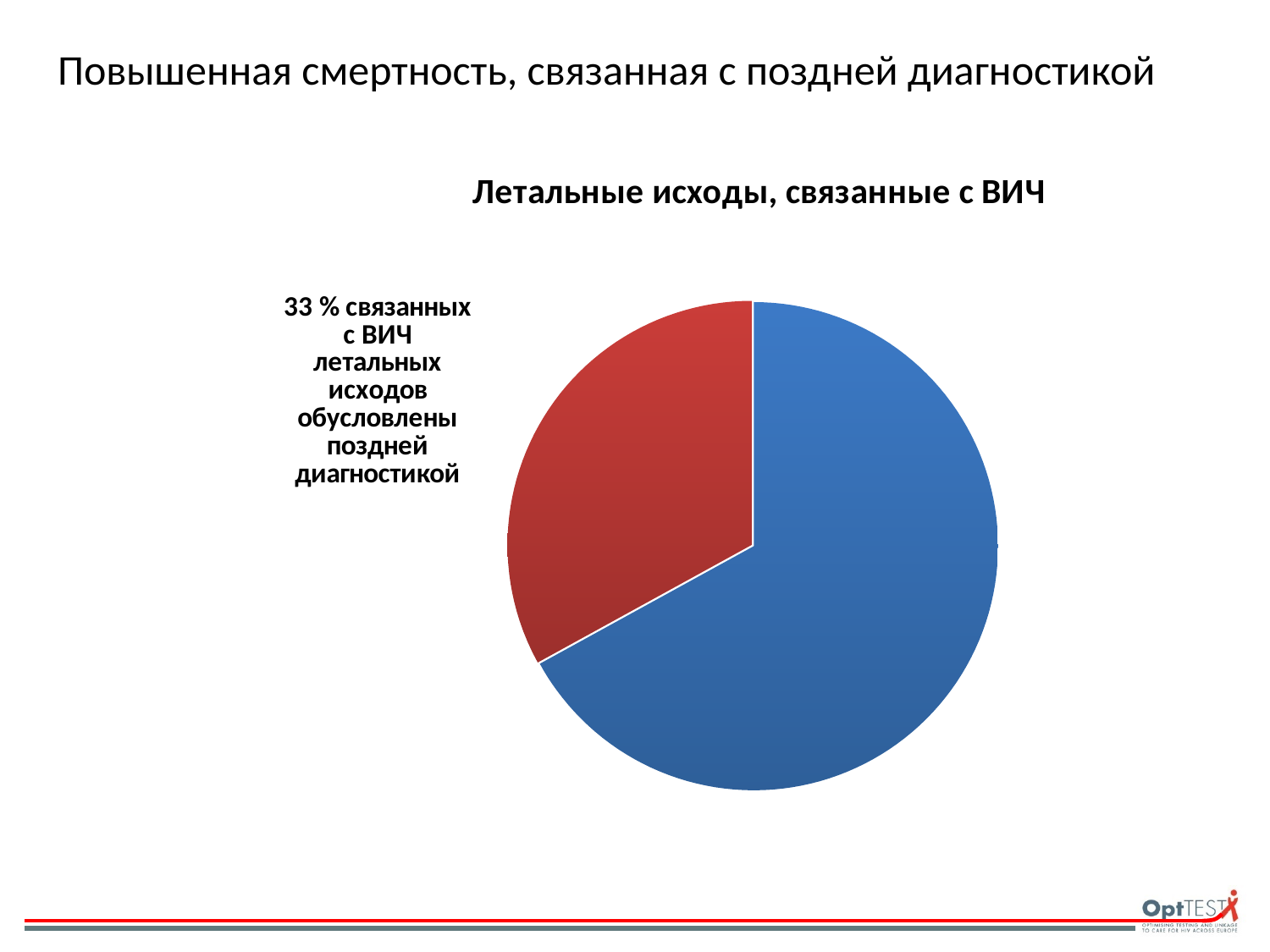
What is the title of the chart? Летальные исходы, связанные с ВИЧ Which slice is larger, the red slice or the blue slice? the blue slice What share of HIV-related deaths is attributed to late diagnosis (поздней диагностикой) according to the chart? 33 % Is the share of deaths due to late diagnosis greater or less than 50%? less How many slices does the pie chart have? 2 What kind of chart is shown on the slide? pie chart Which slice of the pie is the smallest? the red slice (33 % late diagnosis) What colour is the slice representing deaths due to late diagnosis? red Which slice of the pie is the largest? the blue slice